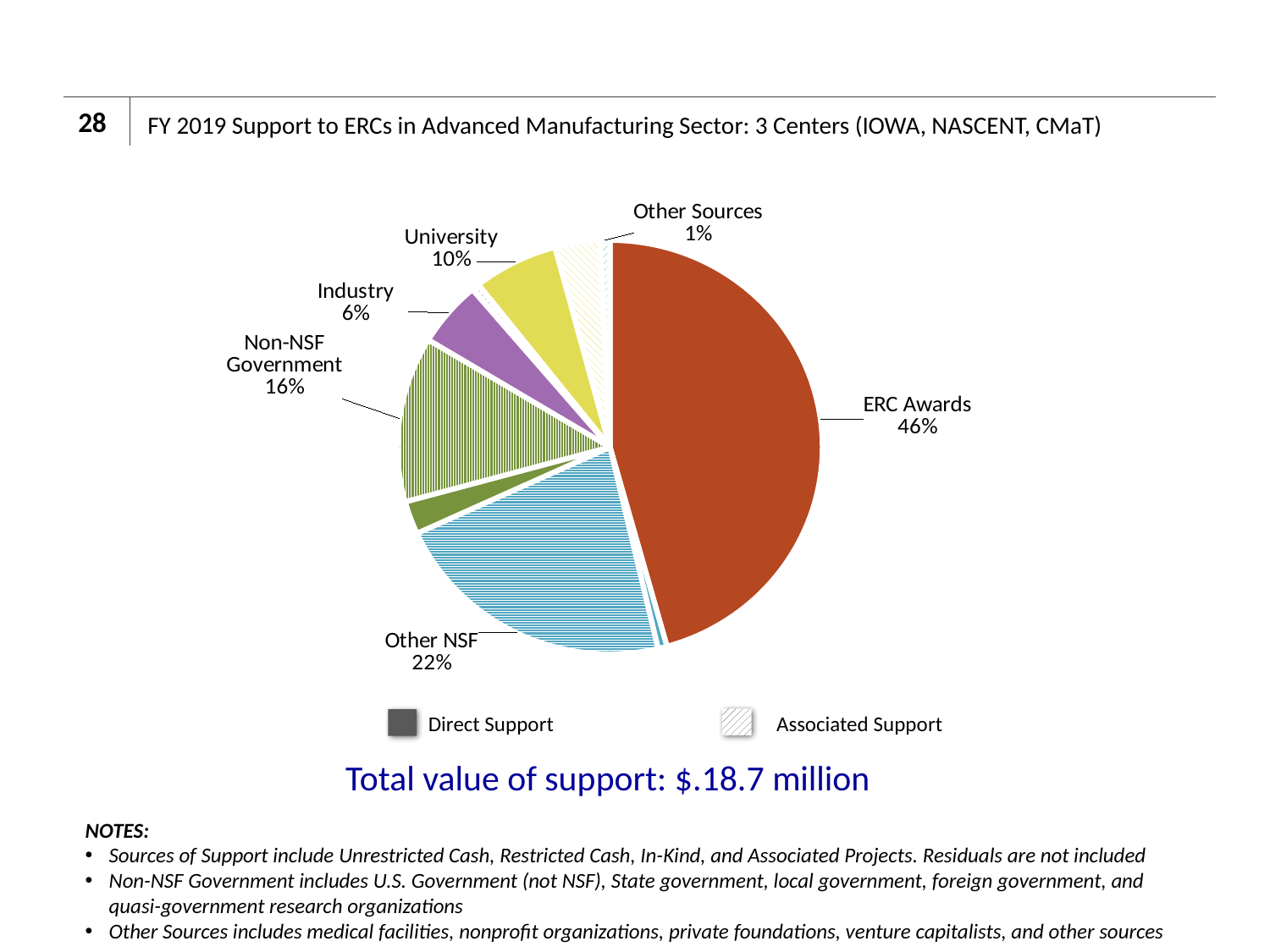
What is the difference in percentage points between the ERC Awards share and the Other NSF share? 24 What kind of chart is shown on the slide? pie chart What share of support comes from University? 10% Which source of support has the largest share of the pie? ERC Awards Which has a larger share, University or Industry? University What share of support comes from Non-NSF Government? 16% What total value of support is stated below the chart? $.18.7 million Which source of support has the smallest share of the pie? Other Sources How many series does the legend list? 2 What share of support comes from ERC Awards? 46% What share of support comes from Industry? 6% What share of support comes from Other NSF? 22%